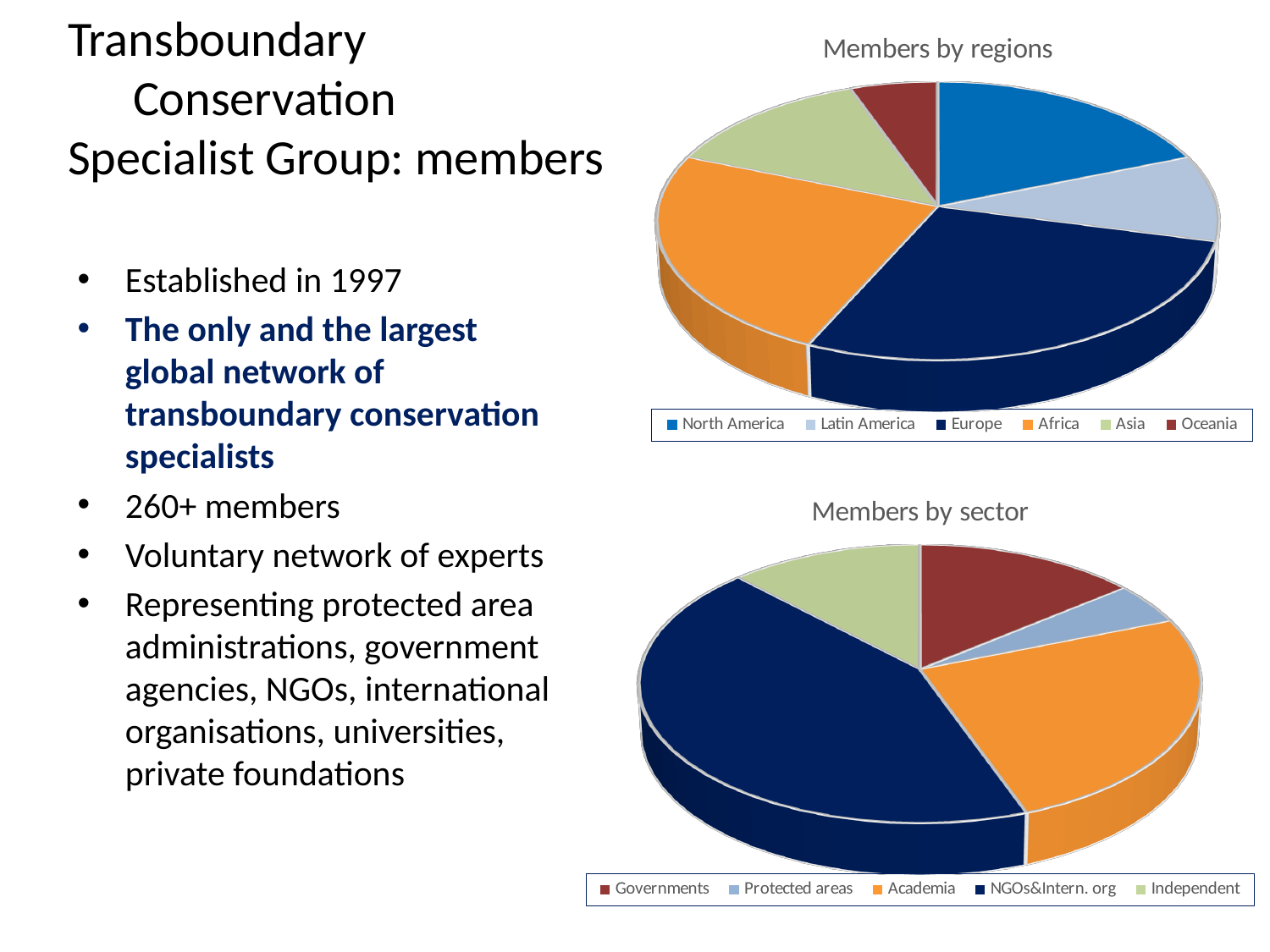
What type of chart is the "Members by regions" chart? pie chart In the "Members by regions" chart, which has the larger share: North America or Latin America? North America In the "Members by sector" chart, which has the larger share: Academia or Governments? Academia In the "Members by regions" chart, how many regions are shown? 6 In the "Members by sector" chart, which sector has the largest share of members? NGOs&Intern. org What type of chart is the "Members by sector" chart? pie chart What is the title of the lower chart on the slide? Members by sector In the "Members by sector" chart, how many sectors are listed in the legend? 5 In the "Members by sector" chart, which sector has the smallest share of members? Protected areas In the "Members by regions" chart, which region has the largest share of members? Europe In the "Members by regions" chart, which has the larger share: Africa or Asia? Africa In the "Members by regions" chart, which region has the smallest share of members? Oceania